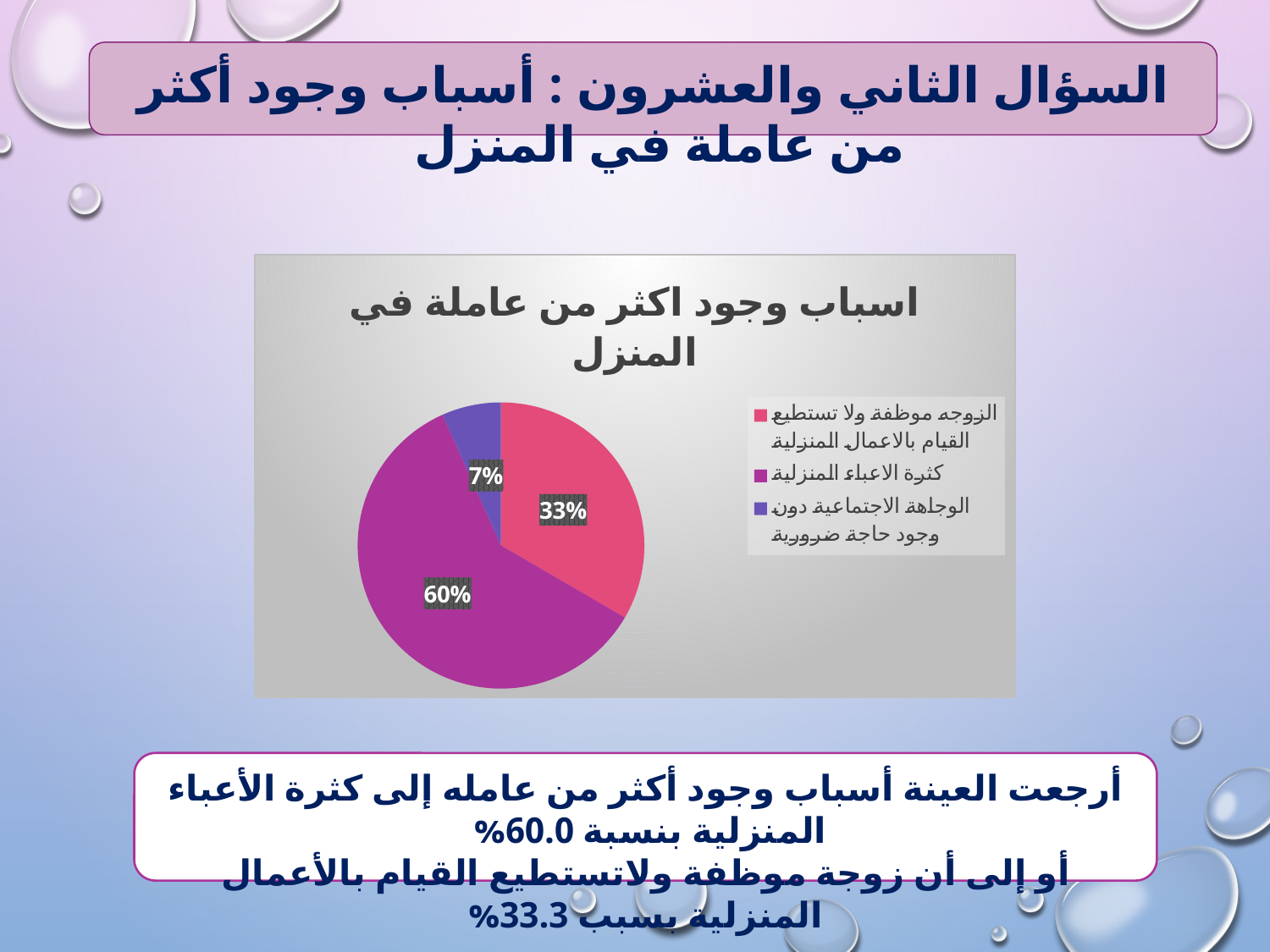
What is the difference in percentage points between كثرة الاعباء المنزلية and الزوجه موظفة ولا تستطيع القيام بالاعمال المنزلية? 27 Which category has the smallest share of the pie? الوجاهة الاجتماعية دون وجود حاجة ضرورية What is the title of the chart? اسباب وجود اكثر من عاملة في المنزل What kind of chart is shown on the slide? pie chart What percentage is shown for الوجاهة الاجتماعية دون وجود حاجة ضرورية? 7% Which is larger: the share for الزوجه موظفة ولا تستطيع القيام بالاعمال المنزلية or the share for الوجاهة الاجتماعية دون وجود حاجة ضرورية? الزوجه موظفة ولا تستطيع القيام بالاعمال المنزلية How many slices does the pie chart have? 3 Which category has the largest share of the pie? كثرة الاعباء المنزلية What colour is the slice for كثرة الاعباء المنزلية? purple What percentage is shown for كثرة الاعباء المنزلية? 60% What percentage is shown for الزوجه موظفة ولا تستطيع القيام بالاعمال المنزلية? 33% How many entries does the legend list? 3